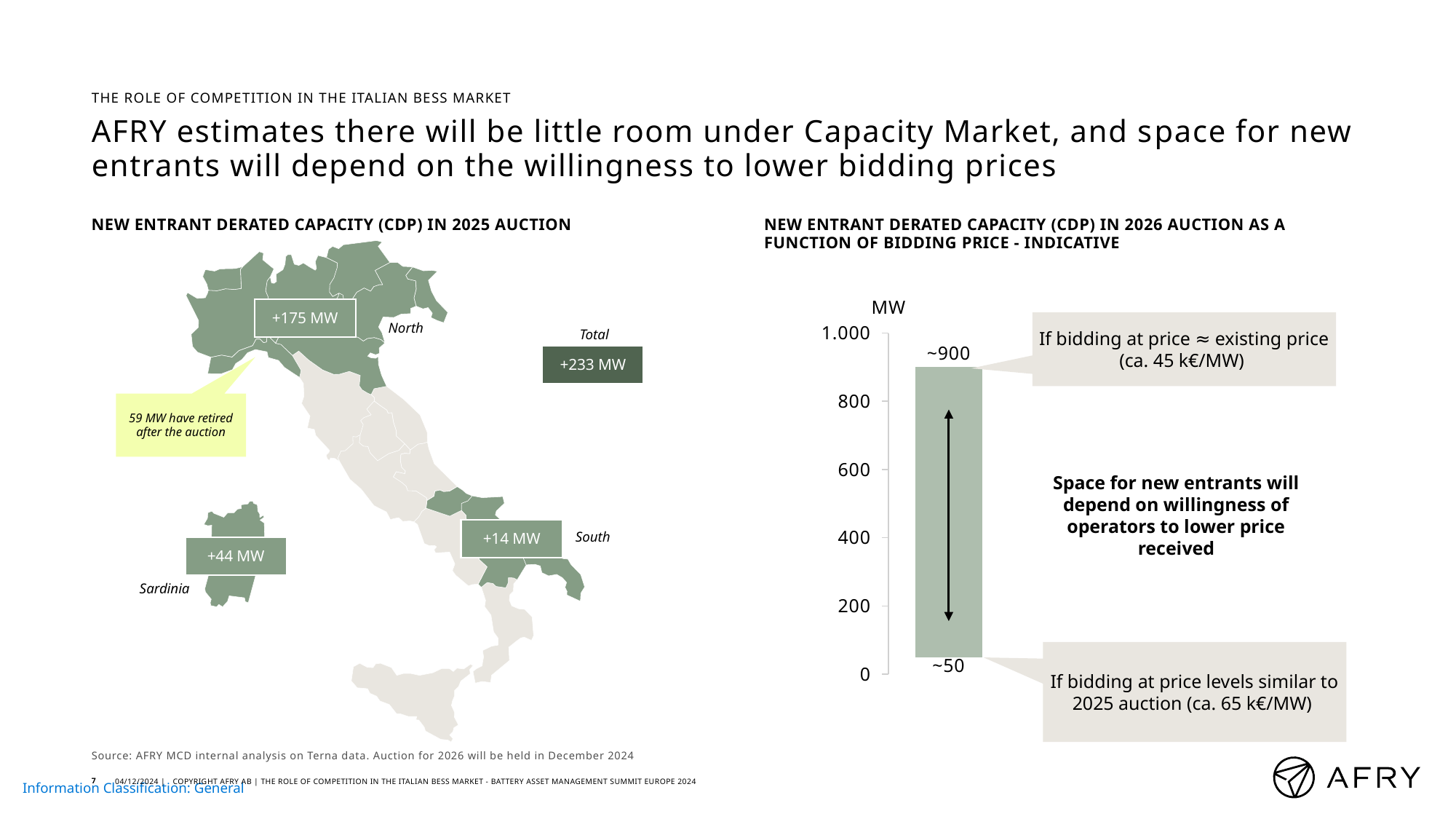
In the right-hand chart 'New entrant derated capacity (CDP) in 2026 auction as a function of bidding price', what unit is shown on the vertical axis? MW In the map chart 'New entrant derated capacity (CDP) in 2025 auction', what is the value shown for Sardinia? +44 MW In the map chart 'New entrant derated capacity (CDP) in 2025 auction', which is larger, the value for Sardinia or the value for South? Sardinia In the right-hand chart 'New entrant derated capacity (CDP) in 2026 auction as a function of bidding price', is the bottom of the bar (bidding at price levels similar to 2025 auction) greater or less than 200 MW? less In the map chart 'New entrant derated capacity (CDP) in 2025 auction', which region has the lowest new entrant capacity? South In the map chart 'New entrant derated capacity (CDP) in 2025 auction', what is the value shown for South? +14 MW In the map chart 'New entrant derated capacity (CDP) in 2025 auction', what is the value shown for North? +175 MW In the map chart 'New entrant derated capacity (CDP) in 2025 auction', which region has the highest new entrant capacity? North In the map chart 'New entrant derated capacity (CDP) in 2025 auction', how many regions are labelled with a capacity value? 3 In the map chart 'New entrant derated capacity (CDP) in 2025 auction', what is the Total value shown? +233 MW In the right-hand chart 'New entrant derated capacity (CDP) in 2026 auction as a function of bidding price', is the top of the bar (bidding at price ≈ existing price) greater or less than 800 MW? greater In the map chart 'New entrant derated capacity (CDP) in 2025 auction', how much larger is the North value than the Sardinia value? 131 MW